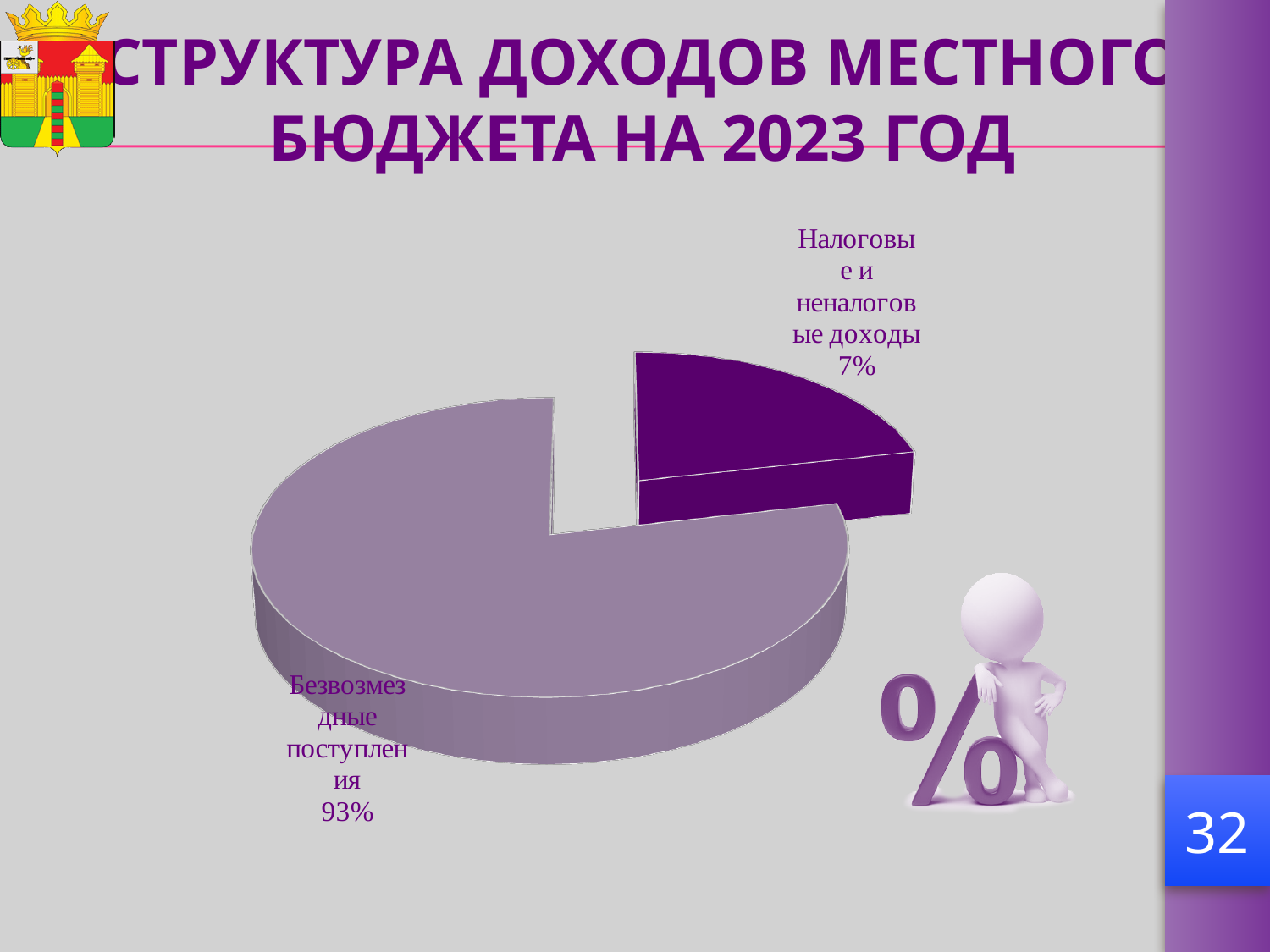
Which is larger: the share of "Безвозмездные поступления" or the share of "Налоговые и неналоговые доходы"? Безвозмездные поступления What share of the pie does "Налоговые и неналоговые доходы" have? 7% Which category has the smallest slice of the pie? Налоговые и неналоговые доходы What is the difference in percentage points between "Безвозмездные поступления" and "Налоговые и неналоговые доходы"? 86 What kind of chart is shown on the slide? pie chart What is the title of the slide containing the pie chart? СТРУКТУРА ДОХОДОВ МЕСТНОГО БЮДЖЕТА НА 2023 ГОД How many slices does the pie chart have? 2 Which slice of the pie is pulled out (exploded) from the rest? Налоговые и неналоговые доходы What share of the pie does "Безвозмездные поступления" have? 93% Which category has the largest slice of the pie? Безвозмездные поступления